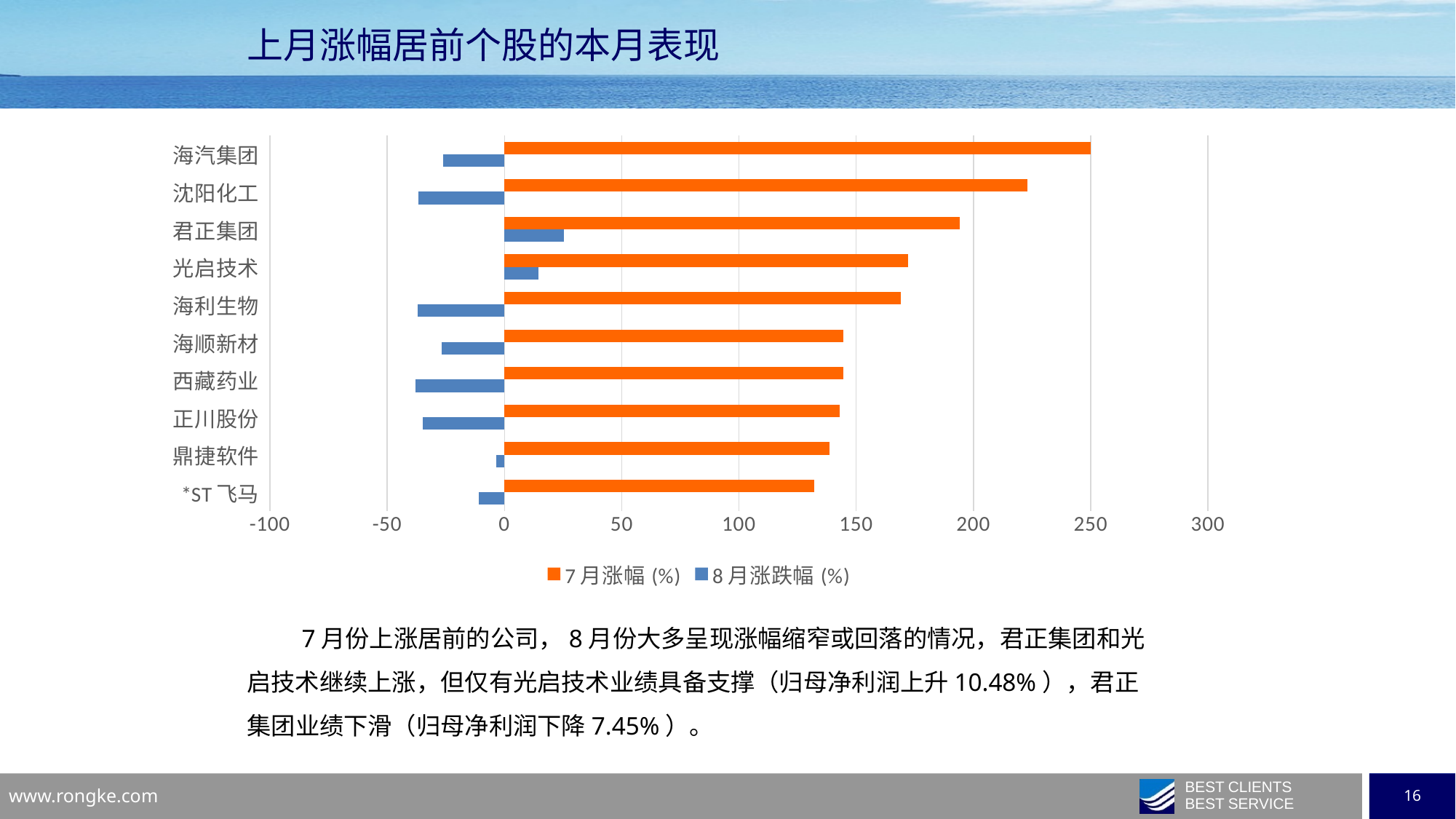
Is the 8月涨跌幅 (%) for 海利生物 greater or less than 0? less Is the 8月涨跌幅 (%) for 君正集团 greater or less than 0? greater Which company has the highest 8月涨跌幅 (%)? 君正集团 Is the 7月涨幅 (%) for 光启技术 greater or less than 150? greater What is the title of the slide containing the chart? 上月涨幅居前个股的本月表现 How many companies are shown on the chart? 10 Which company has the highest 7月涨幅 (%)? 海汽集团 Which colour represents the 7月涨幅 (%) series in the legend? orange Which has the larger 7月涨幅 (%), 海汽集团 or 沈阳化工? 海汽集团 What kind of chart is shown on the slide? bar chart How many series does the legend list? 2